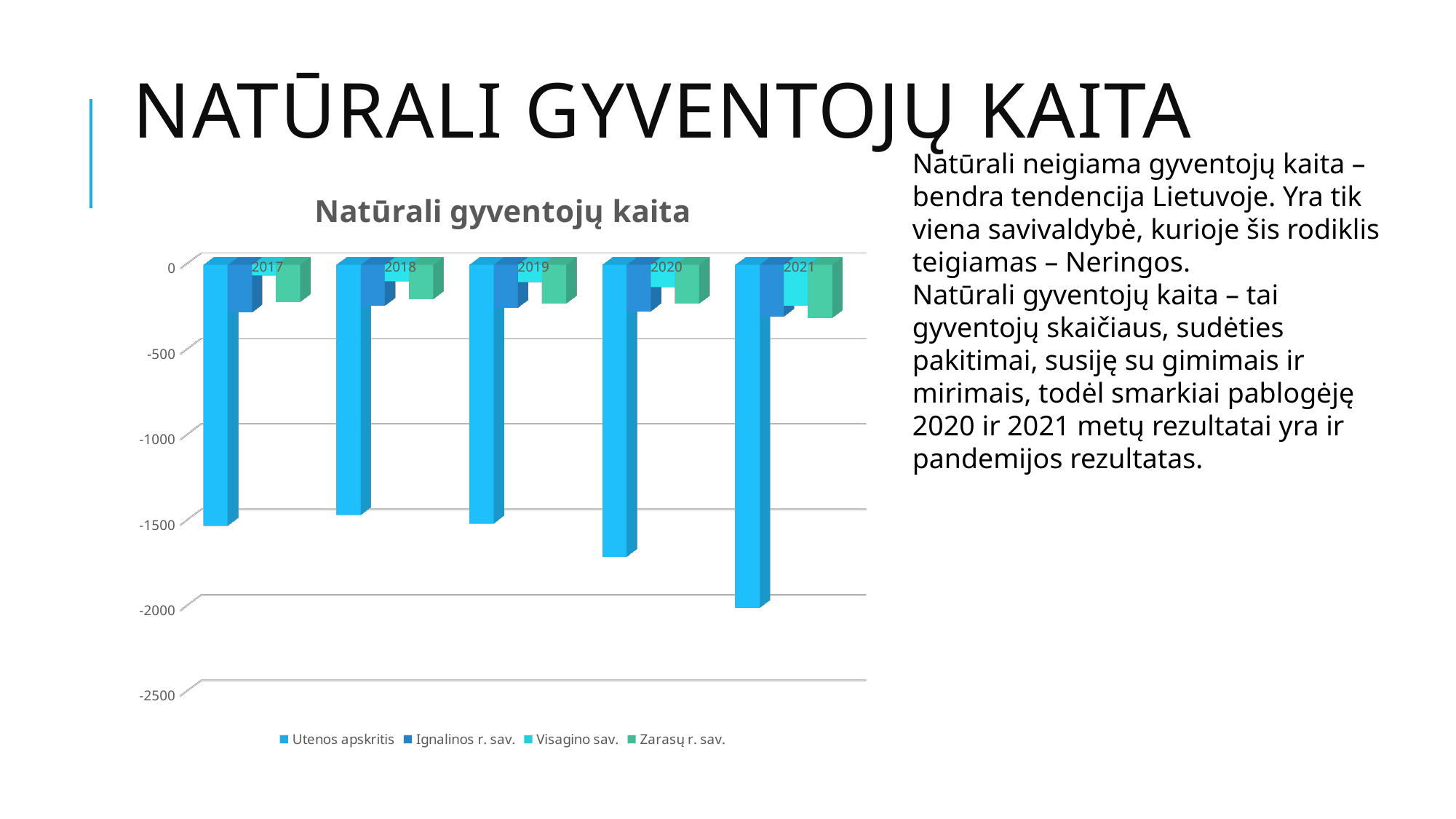
How many series does the chart legend list? 4 From 2019 to 2021, do the values for Utenos apskritis rise or fall? fall What kind of chart is shown on the slide? bar chart What is the title of the chart? Natūrali gyventojų kaita Is the value for Utenos apskritis in 2020 greater or less than -1500? less Which is more negative for Utenos apskritis: the value in 2020 or in 2021? 2021 Which series is listed first in the chart legend? Utenos apskritis Is the value for Utenos apskritis in 2020 greater or less than -2000? greater In which year is the value for Utenos apskritis the lowest (most negative)? 2021 Which series has the most negative values in every year? Utenos apskritis Is the value for Zarasų r. sav. in 2021 greater or less than -500? greater How many years are shown on the x axis of the chart? 5